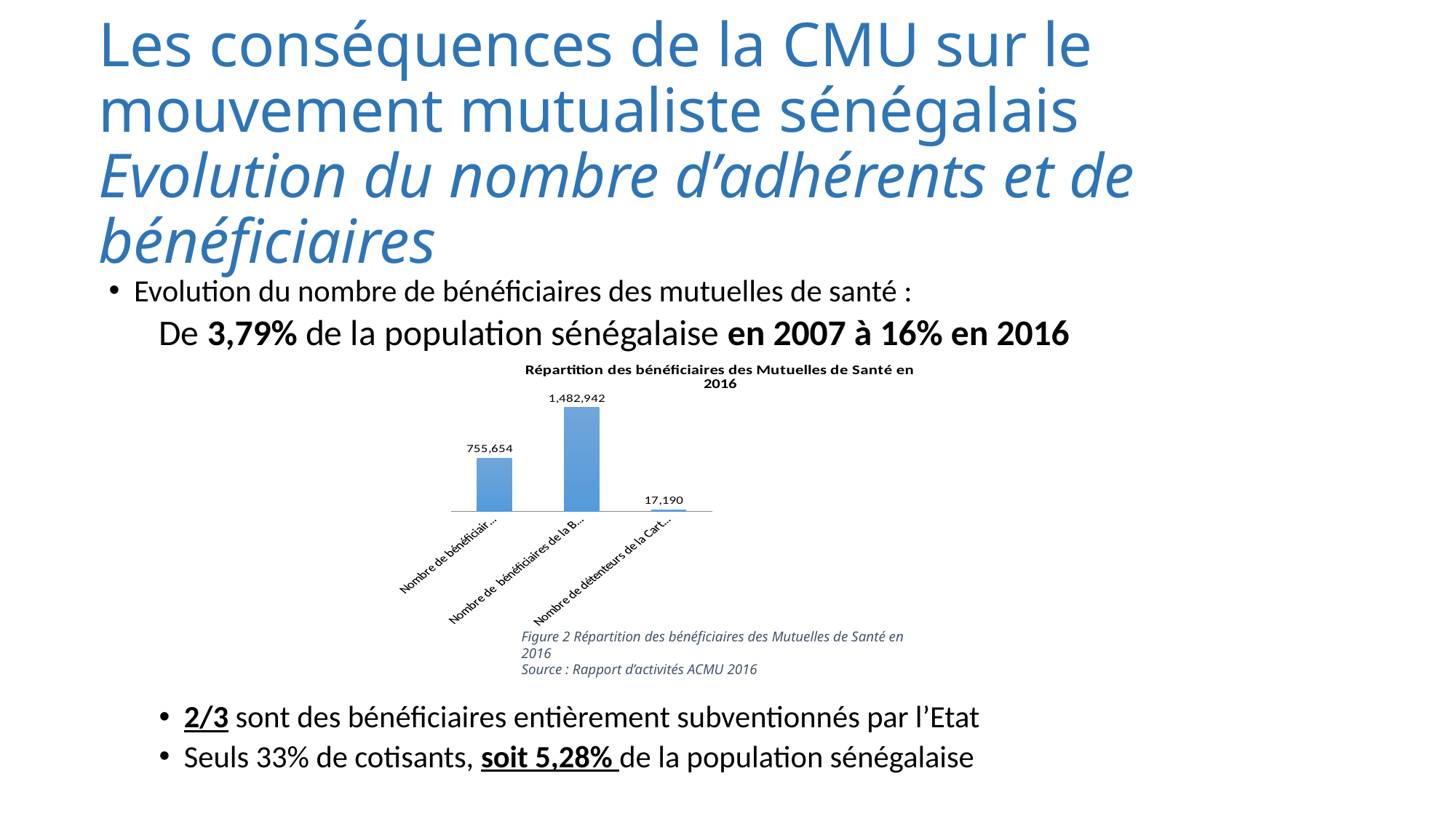
Which bar has the highest value? the second bar, Nombre de bénéficiaires de la B... What kind of chart is shown on the slide? bar chart What is the difference between the second bar (1,482,942) and the first bar (755,654)? 727,288 What is the value of the third bar (Nombre de détenteurs de la Cart...)? 17,190 Which bar has the lowest value? the third bar, Nombre de détenteurs de la Cart... What is the difference between the first bar (755,654) and the third bar (17,190)? 738,464 What source is cited below the chart? Rapport d'activités ACMU 2016 What is the value of the first bar (Nombre de bénéficiair...)? 755,654 What is the value of the second bar (Nombre de bénéficiaires de la B...)? 1,482,942 How many bars does the chart show? 3 What is the title of the chart? Répartition des bénéficiaires des Mutuelles de Santé en 2016 Which is larger, the first bar (Nombre de bénéficiair...) or the third bar (Nombre de détenteurs de la Cart...)? the first bar